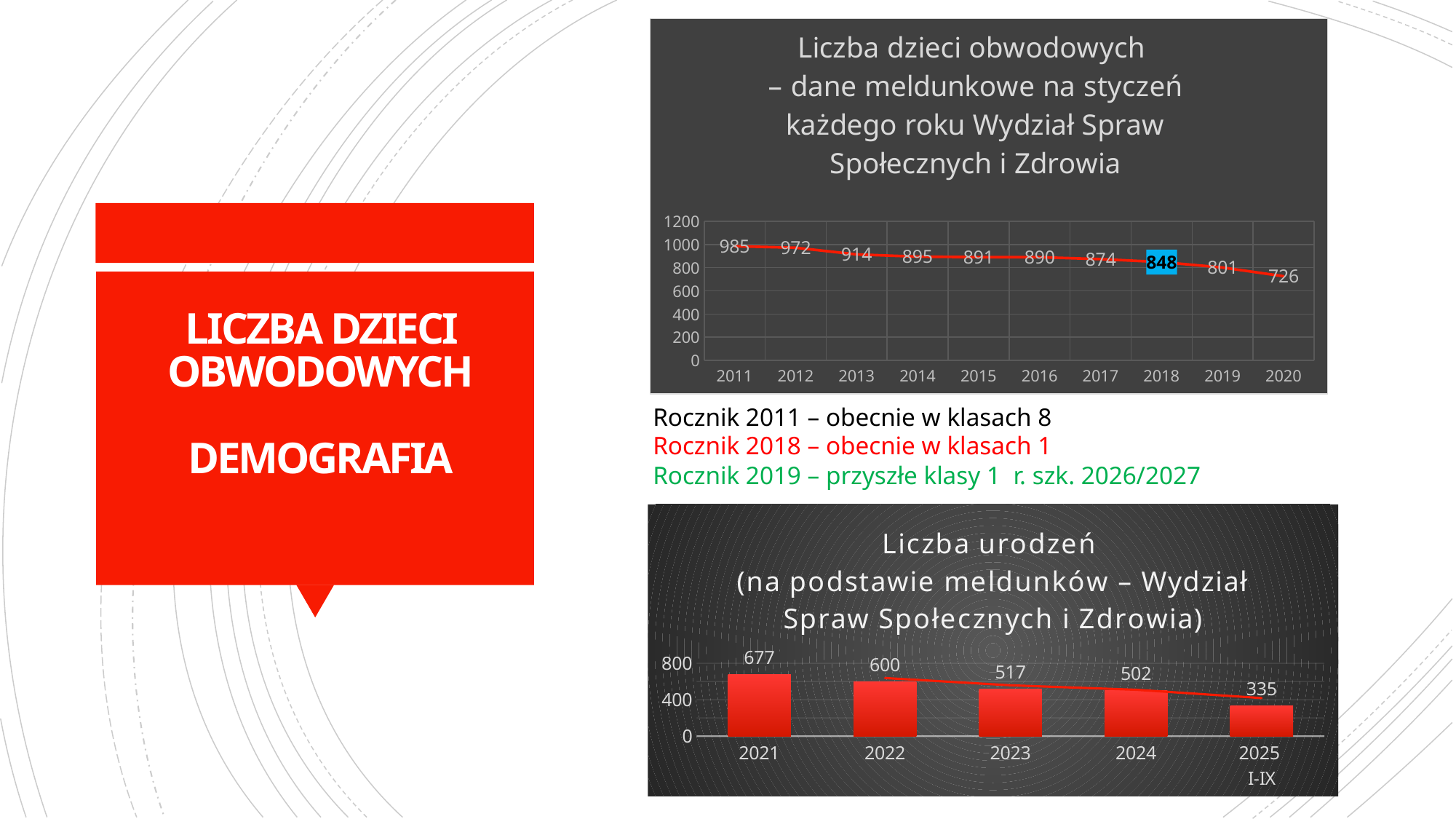
In the bottom chart (Liczba urodzeń), what is the difference between the values for 2024 and 2025? 167 In the top chart (Liczba dzieci obwodowych), what is the value for 2018? 848 In the top chart (Liczba dzieci obwodowych), what is the difference between the values for 2011 and 2020? 259 In the bottom chart (Liczba urodzeń), which year has the highest value? 2021 In the top chart (Liczba dzieci obwodowych), which year has the lowest value? 2020 In the bottom chart (Liczba urodzeń), what is the value for 2023? 517 In the top chart (Liczba dzieci obwodowych), what is the value for 2011? 985 In the bottom chart (Liczba urodzeń), which is larger, the value for 2022 or the value for 2023? 2022 What kind of chart is the bottom chart (Liczba urodzeń)? bar chart What kind of chart is the top chart (Liczba dzieci obwodowych)? line chart In the top chart (Liczba dzieci obwodowych), how many years are plotted? 10 In the top chart (Liczba dzieci obwodowych), do the values rise or fall from 2011 to 2020? fall